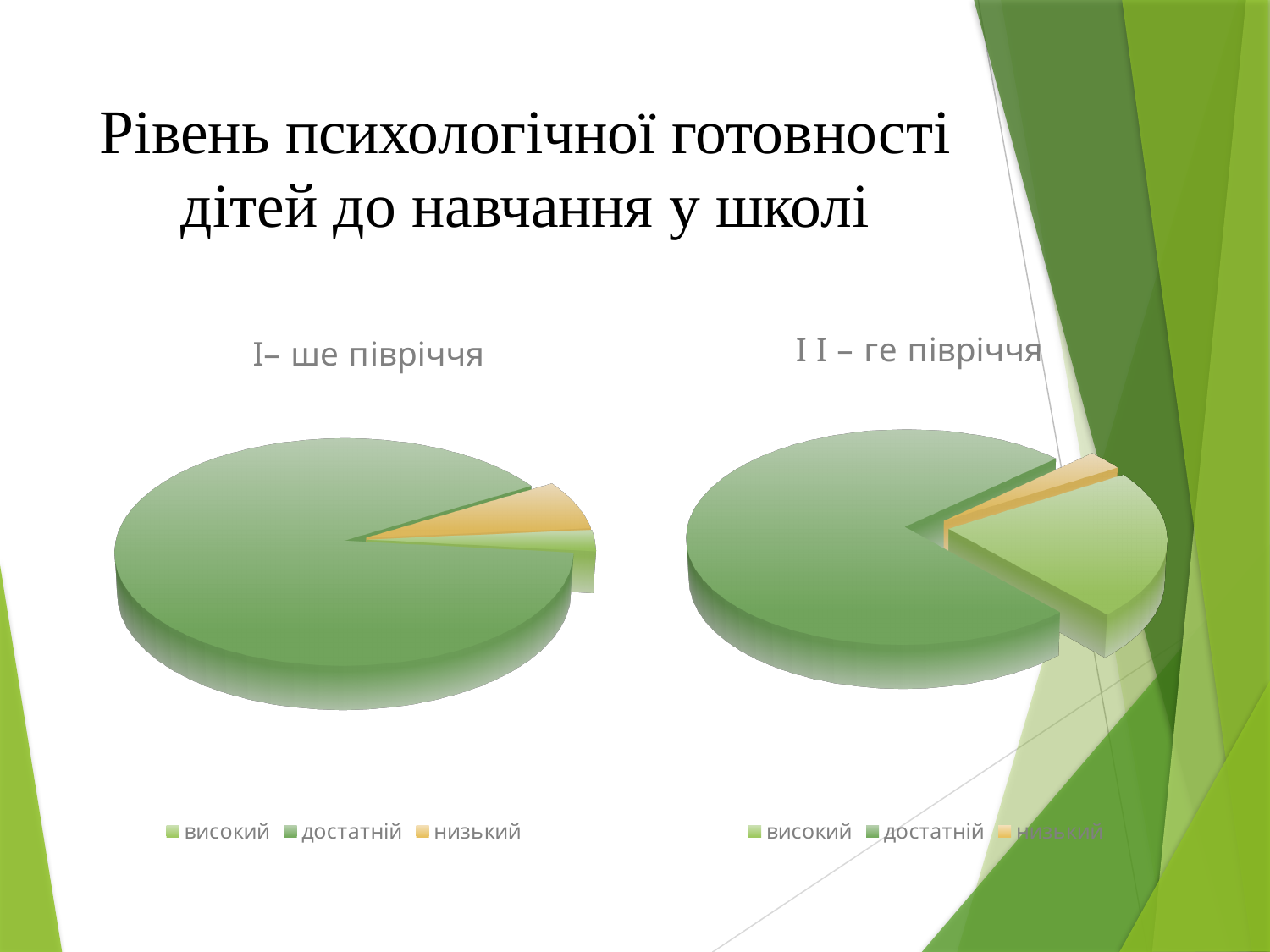
What kind of chart is the "I I – ге півріччя" chart? pie chart In the "I I – ге півріччя" chart, how many entries does the legend list? 3 What kind of chart is the "I– ше півріччя" chart? pie chart In the "I I – ге півріччя" chart, which category has the largest slice? достатній What are the legend entries of the "I– ше півріччя" chart? високий, достатній, низький In the "I– ше півріччя" chart, how many slices does the pie have? 3 In the "I I – ге півріччя" chart, which is larger: високий or низький? високий In the "I– ше півріччя" chart, which is larger: достатній or високий? достатній In the "I– ше півріччя" chart, which category has the largest slice? достатній In the "I I – ге півріччя" chart, which category has the smallest slice? низький What is the title of the chart on the right side of the slide? I I – ге півріччя